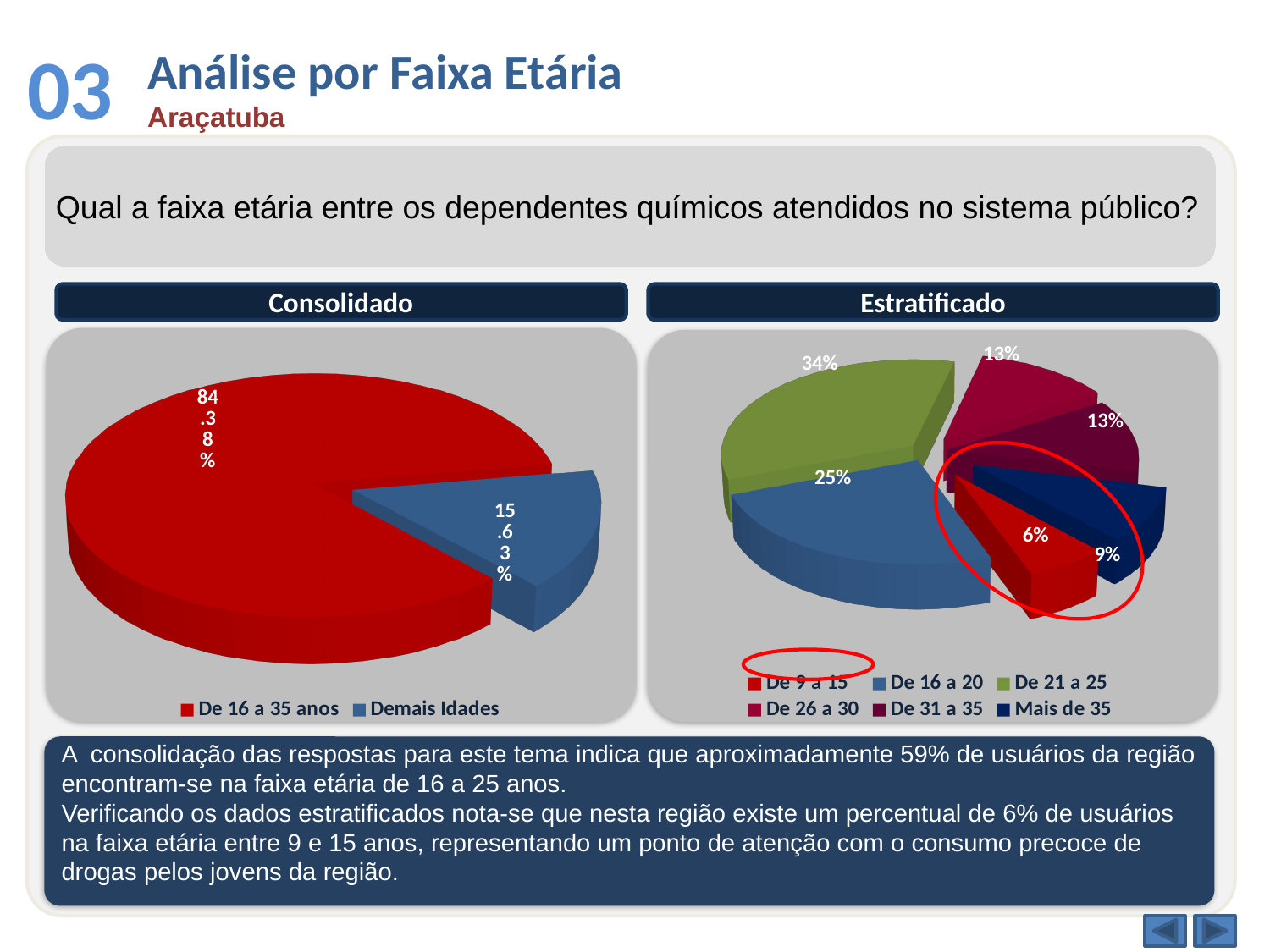
In the Consolidado chart, what is the value for Demais Idades? 15.63% In the Consolidado chart, what is the difference between De 16 a 35 anos and Demais Idades? 68.75% How many categories does the legend of the Estratificado chart list? 6 In the Consolidado chart, which category has the largest share? De 16 a 35 anos In the Estratificado chart, what is the value for De 9 a 15? 6% In the Estratificado chart, which is larger, De 16 a 20 or De 26 a 30? De 16 a 20 In the Estratificado chart, which category has the smallest share? De 9 a 15 In the Estratificado chart, what is the value for Mais de 35? 9% In the Estratificado chart, what is the value for De 21 a 25? 34% In the Consolidado chart, what is the value for De 16 a 35 anos? 84.38% What kind of chart is the Consolidado chart? Pie chart In the Estratificado chart, what is the difference between De 21 a 25 and De 16 a 20? 9%